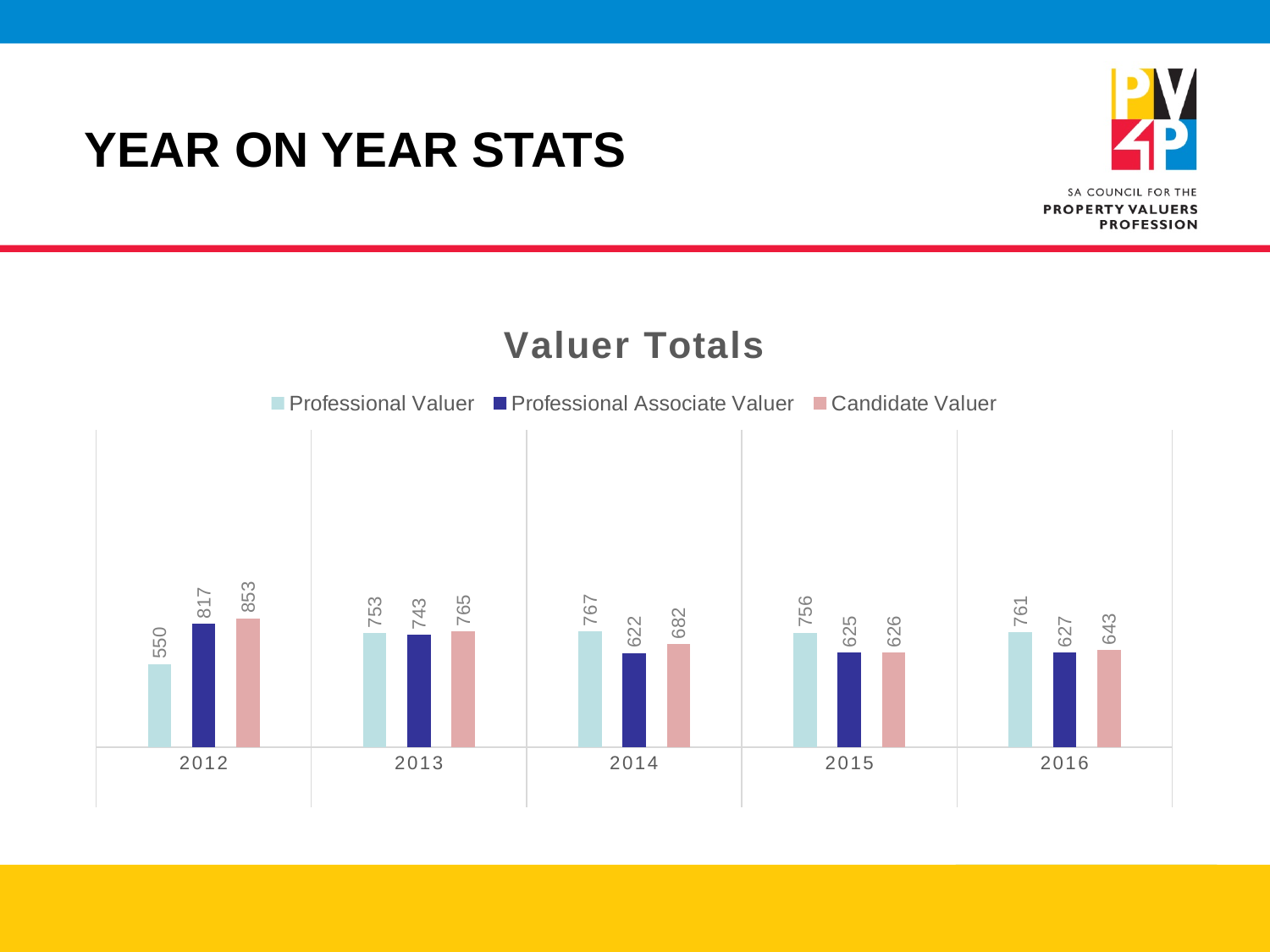
What is the title of the chart? Valuer Totals In which year is the Candidate Valuer value highest? 2012 Which is larger in 2014: Professional Valuer or Professional Associate Valuer? Professional Valuer What is the value for Candidate Valuer in 2014? 682 What kind of chart is shown? Bar chart In which year is the Professional Valuer value lowest? 2012 What is the value for Professional Associate Valuer in 2016? 627 How many years are shown on the x axis? 5 What is the value for Professional Valuer in 2012? 550 What is the difference between the Candidate Valuer and Professional Associate Valuer values in 2012? 36 How many series does the legend list? 3 Does the Professional Associate Valuer value rise or fall from 2012 to 2014? Fall